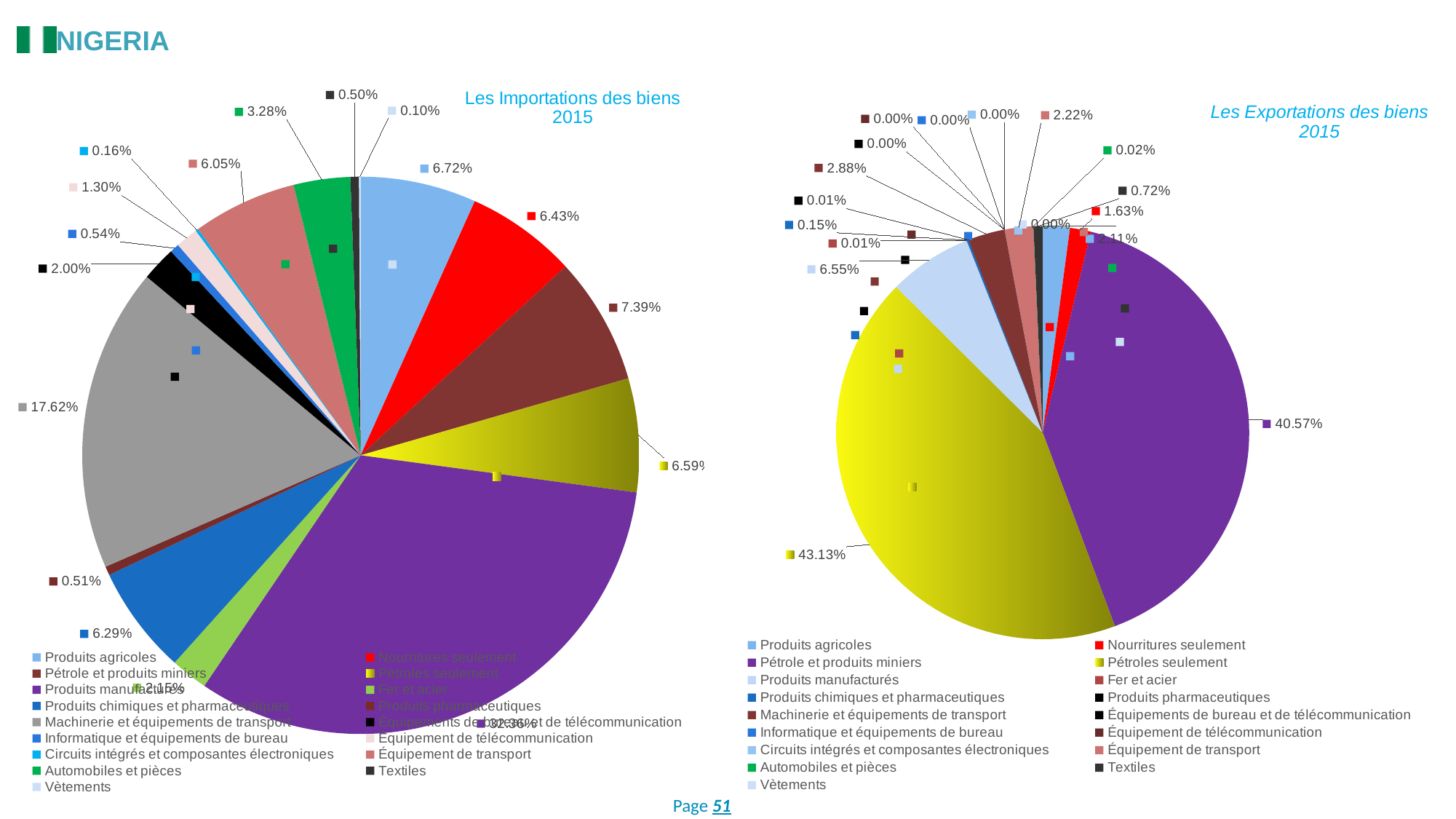
In the 'Les Exportations des biens 2015' chart, what is the share for Pétrole et produits miniers? 40.57% In the 'Les Importations des biens 2015' chart, which is larger: Pétrole et produits miniers or Nourritures seulement? Pétrole et produits miniers In the 'Les Exportations des biens 2015' chart, what is the share for Pétroles seulement? 43.13% In the 'Les Exportations des biens 2015' chart, which category has the largest share? Pétroles seulement In the 'Les Importations des biens 2015' chart, what is the share for Machinerie et équipements de transport? 17.62% In the 'Les Importations des biens 2015' chart, what is the share for Automobiles et pièces? 3.28% In the 'Les Importations des biens 2015' chart, what is the share for Produits agricoles? 6.72% How many categories does the legend of the 'Les Importations des biens 2015' chart list? 17 In the 'Les Exportations des biens 2015' chart, what is the difference between the shares of Pétroles seulement and Pétrole et produits miniers? 2.56% What kind of chart is used for 'Les Importations des biens 2015'? pie chart In the 'Les Exportations des biens 2015' chart, what is the share for Produits manufacturés? 6.55% In the 'Les Importations des biens 2015' chart, which category has the largest slice? Produits manufacturés